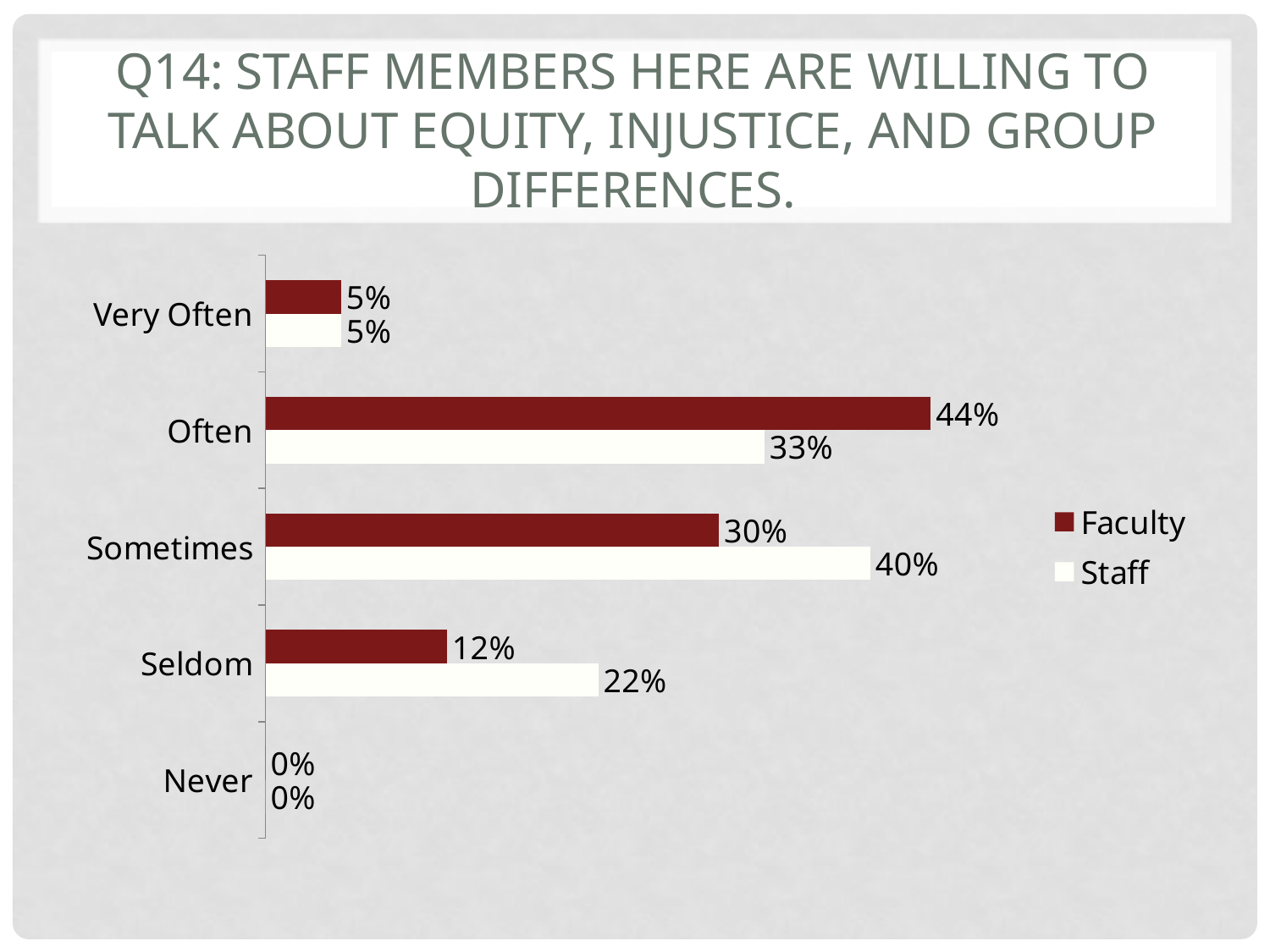
Which is larger for Sometimes, the Faculty value or the Staff value? Staff What is the difference between the Faculty and Staff values for Often? 11% Which category has the lowest Staff value? Never What is the Faculty value for Often? 44% What is the Faculty value for Very Often? 5% What is the Staff value for Sometimes? 40% How many series does the legend list? 2 Which category has the highest Faculty value? Often What is the difference between the Staff and Faculty values for Seldom? 10% What is the Staff value for Seldom? 22% How many categories are shown on the chart? 5 Which category has the highest Staff value? Sometimes